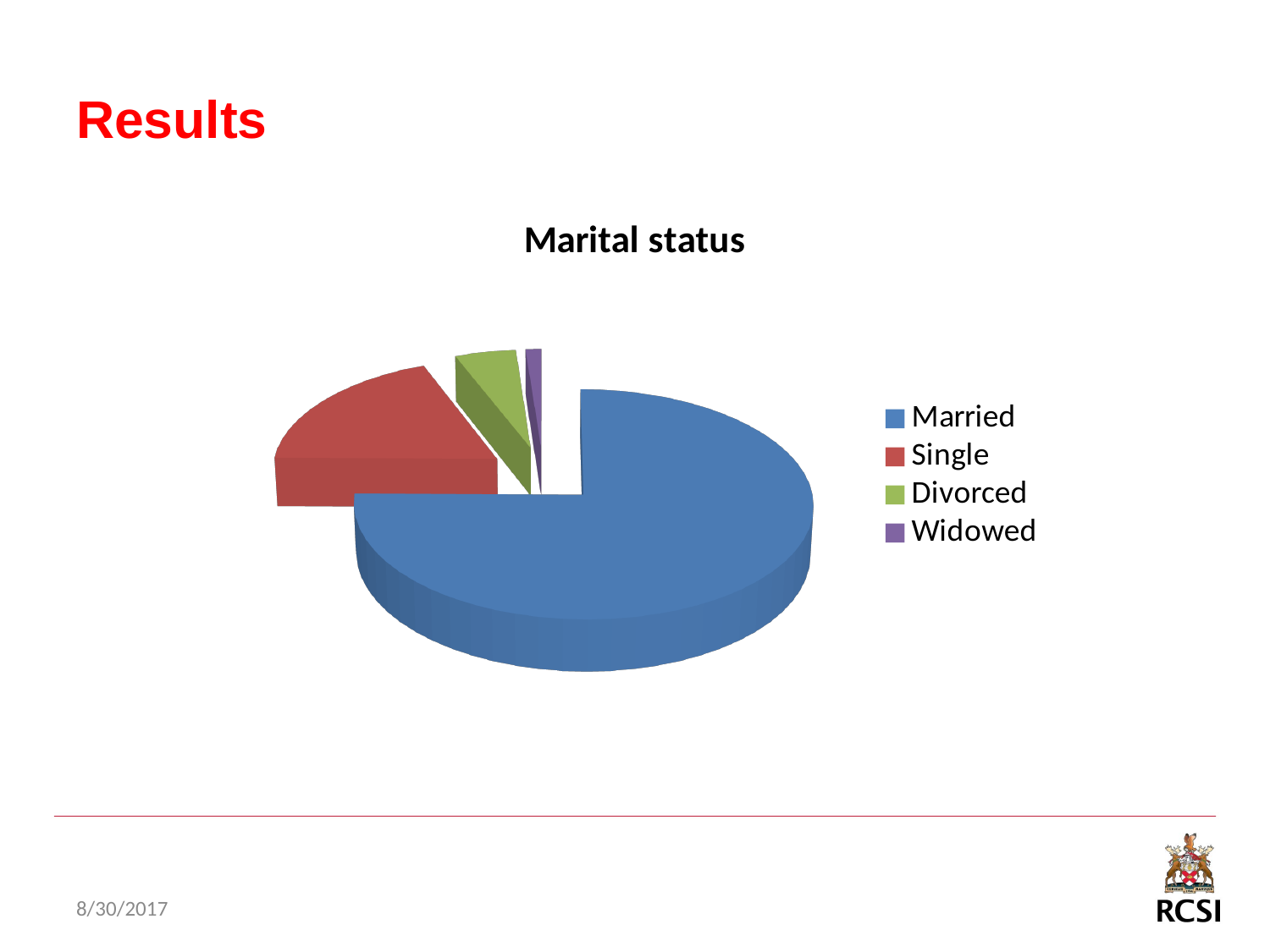
Which slice is larger, Divorced or Widowed? Divorced Which category is the second-largest slice of the pie? Single How many categories does the Marital status pie chart show? 4 What is the title of the chart? Marital status Which marital status category has the largest slice of the pie? Married Which slice is larger, Married or Single? Married Which marital status category has the smallest slice of the pie? Widowed What kind of chart is shown on the slide? Pie chart Which slice is larger, Single or Divorced? Single Which category is shown in blue in the pie chart? Married